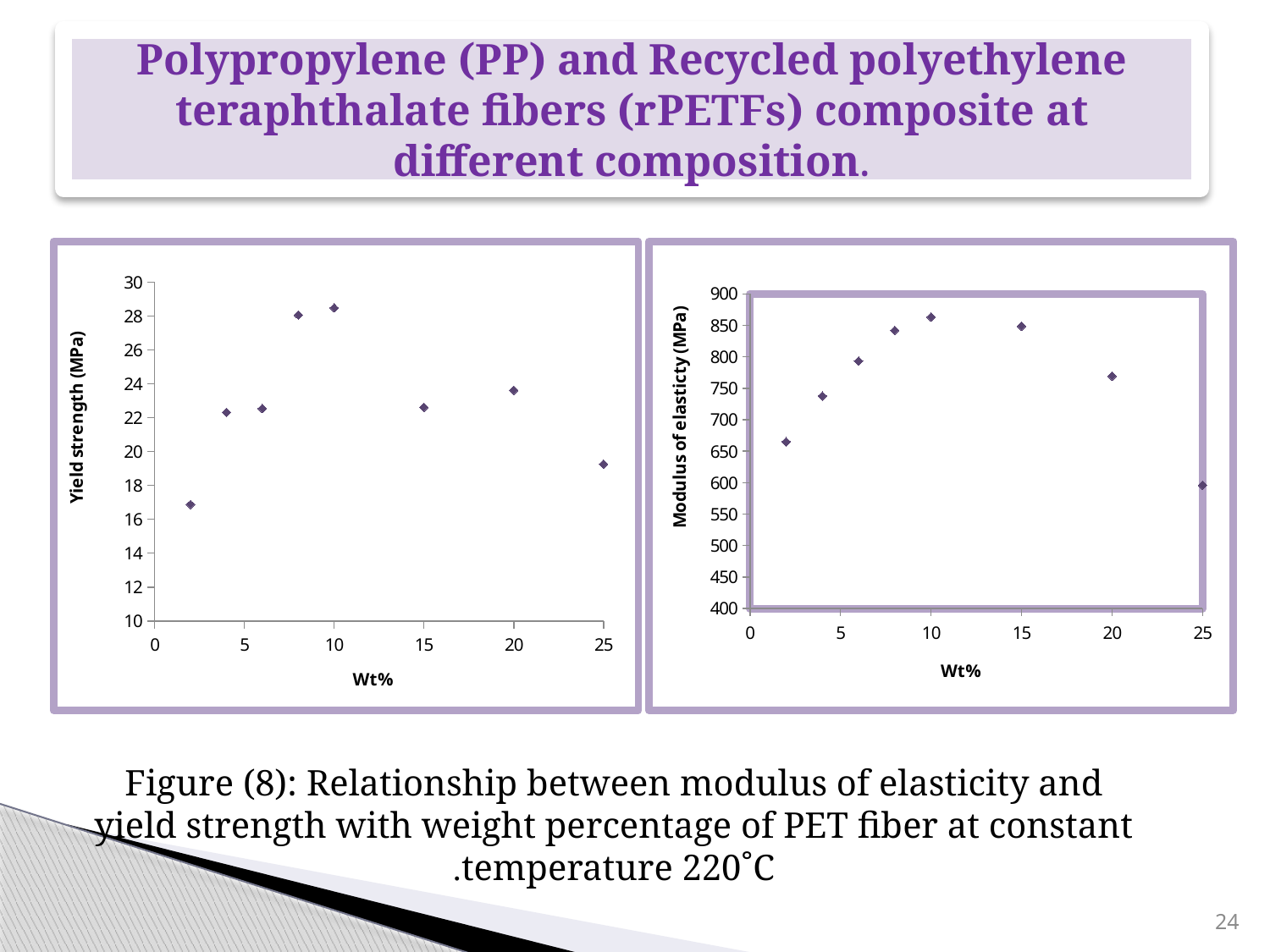
On the left chart (Yield strength vs Wt%), is the yield strength at 2 Wt% greater or less than 18? less On the right chart (Modulus of elasticity vs Wt%), is the modulus at 10 Wt% greater or less than 850? greater On the left chart (Yield strength vs Wt%), is the yield strength at 8 Wt% greater or less than 26? greater What kind of chart is the left chart (Yield strength vs Wt%)? scatter chart How many data points are plotted on the right chart (Modulus of elasticity vs Wt%)? 8 On the left chart (Yield strength vs Wt%), at which Wt% is the yield strength lowest? 2 What is the x-axis title of the left chart? Wt% On the left chart (Yield strength vs Wt%), which has the higher yield strength: 10 Wt% or 25 Wt%? 10 Wt% How many data points are plotted on the left chart (Yield strength vs Wt%)? 8 On the right chart (Modulus of elasticity vs Wt%), does the modulus rise or fall between 10 Wt% and 25 Wt%? fall On the right chart (Modulus of elasticity vs Wt%), at which Wt% is the modulus of elasticity lowest? 25